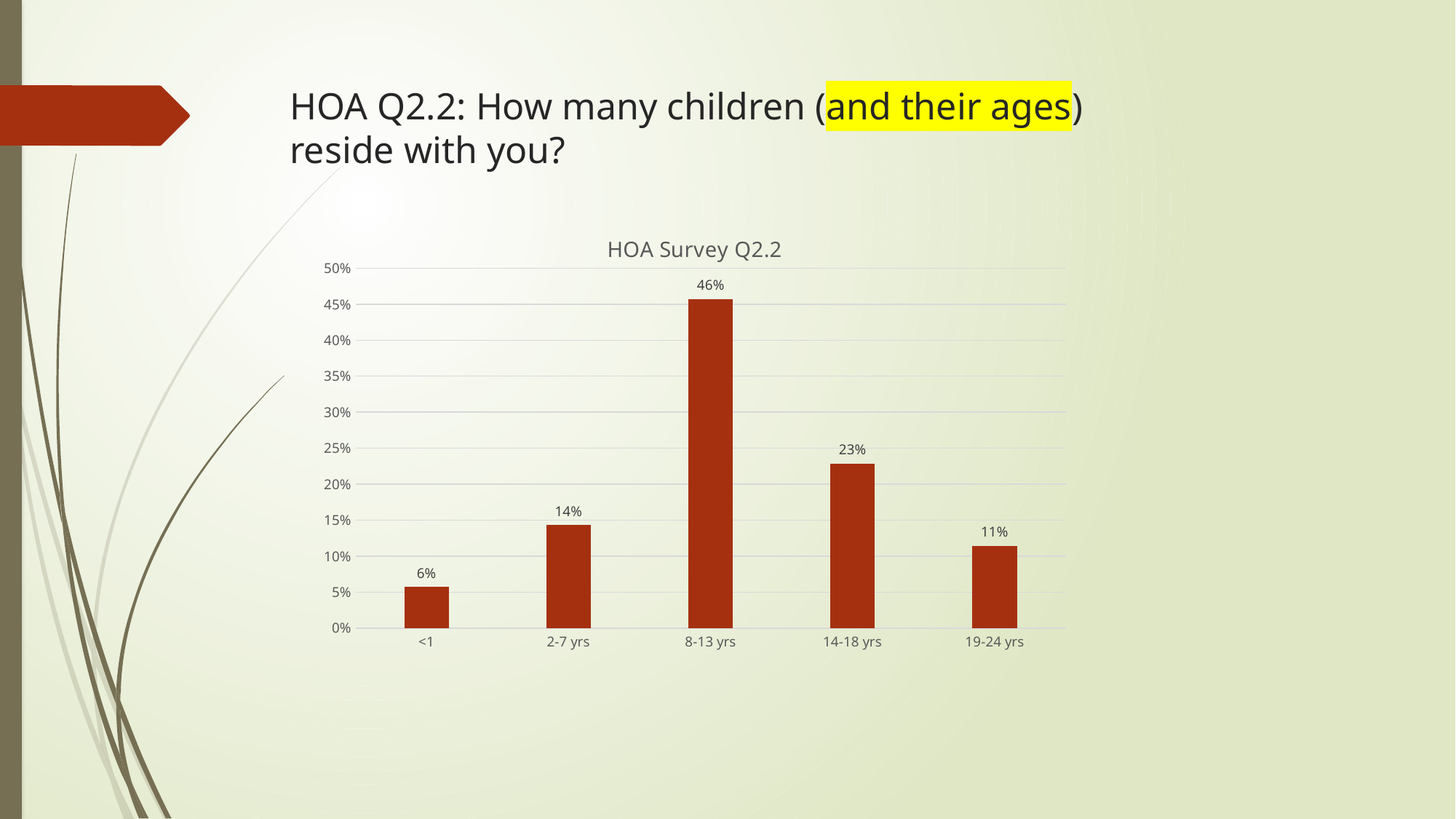
Which age category has the lowest value? <1 Is the value for 14-18 yrs greater or less than 20%? greater What is the difference between the values for 8-13 yrs and 14-18 yrs? 23% What kind of chart is shown on the slide? Bar chart Which is larger, the value for 2-7 yrs or the value for 19-24 yrs? 2-7 yrs What is the value for the 19-24 yrs category? 11% How many age categories are shown on the x axis? 5 What is the value for the <1 category? 6% What is the value for the 8-13 yrs category? 46% What is the title of the chart? HOA Survey Q2.2 Which age category has the highest value? 8-13 yrs What is the value for the 2-7 yrs category? 14%